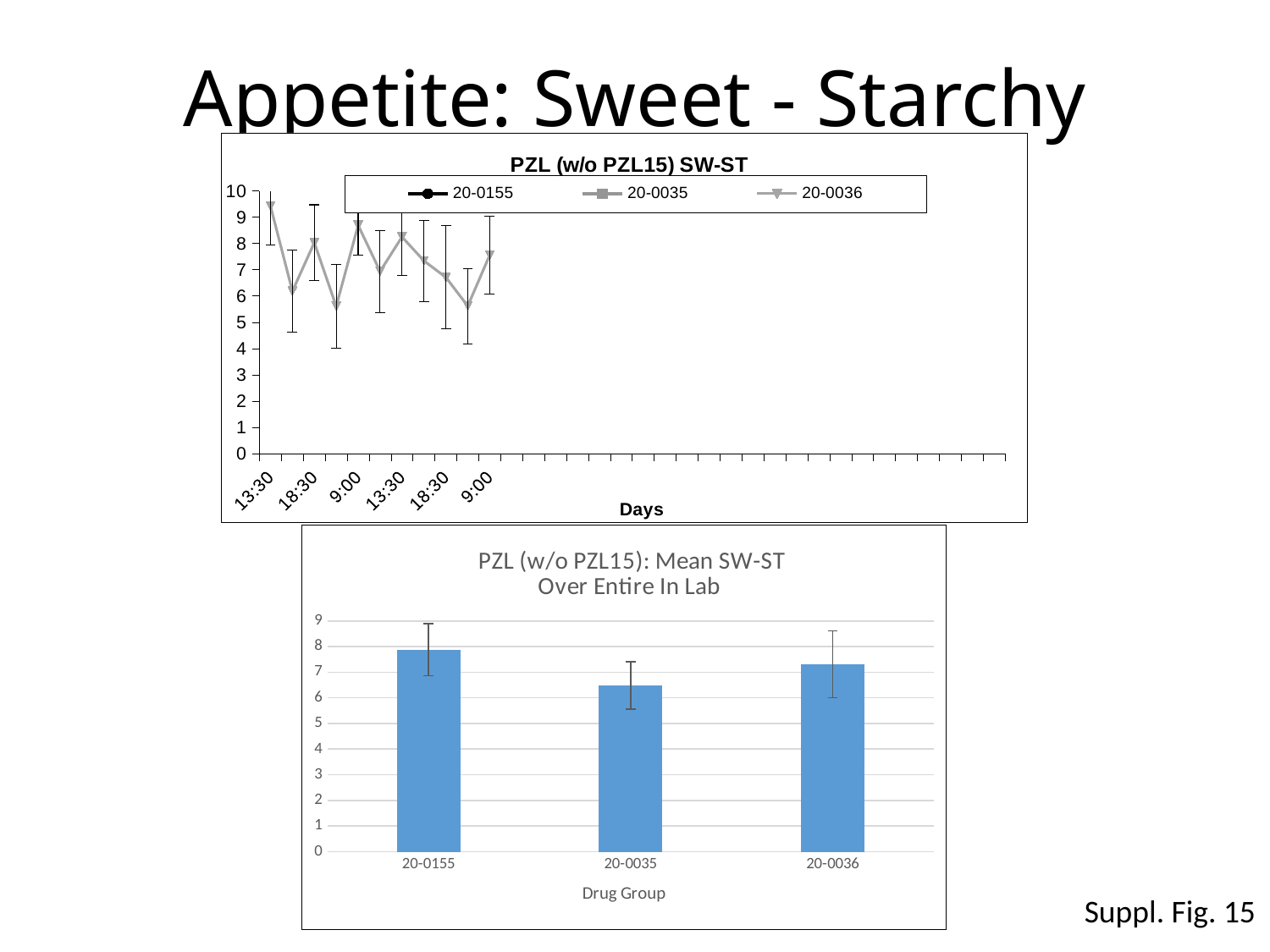
What kind of chart is the top chart titled "PZL (w/o PZL15) SW-ST"? line chart What is the x-axis title of the bottom chart "PZL (w/o PZL15): Mean SW-ST Over Entire In Lab"? Drug Group In the bottom chart "PZL (w/o PZL15): Mean SW-ST Over Entire In Lab", which is larger, the value for 20-0155 or the value for 20-0036? 20-0155 In the bottom chart "PZL (w/o PZL15): Mean SW-ST Over Entire In Lab", is the value for 20-0155 greater or less than 7? greater In the bottom chart "PZL (w/o PZL15): Mean SW-ST Over Entire In Lab", how many drug groups are plotted? 3 What is the x-axis title of the top chart "PZL (w/o PZL15) SW-ST"? Days In the bottom chart "PZL (w/o PZL15): Mean SW-ST Over Entire In Lab", is the value for 20-0035 greater or less than 7? less What kind of chart is the bottom chart titled "PZL (w/o PZL15): Mean SW-ST Over Entire In Lab"? bar chart In the bottom chart "PZL (w/o PZL15): Mean SW-ST Over Entire In Lab", is the value for 20-0036 greater or less than 8? less How many series does the legend of the top chart "PZL (w/o PZL15) SW-ST" list? 3 In the bottom chart "PZL (w/o PZL15): Mean SW-ST Over Entire In Lab", which drug group has the lowest mean value? 20-0035 In the bottom chart "PZL (w/o PZL15): Mean SW-ST Over Entire In Lab", which drug group has the highest mean value? 20-0155